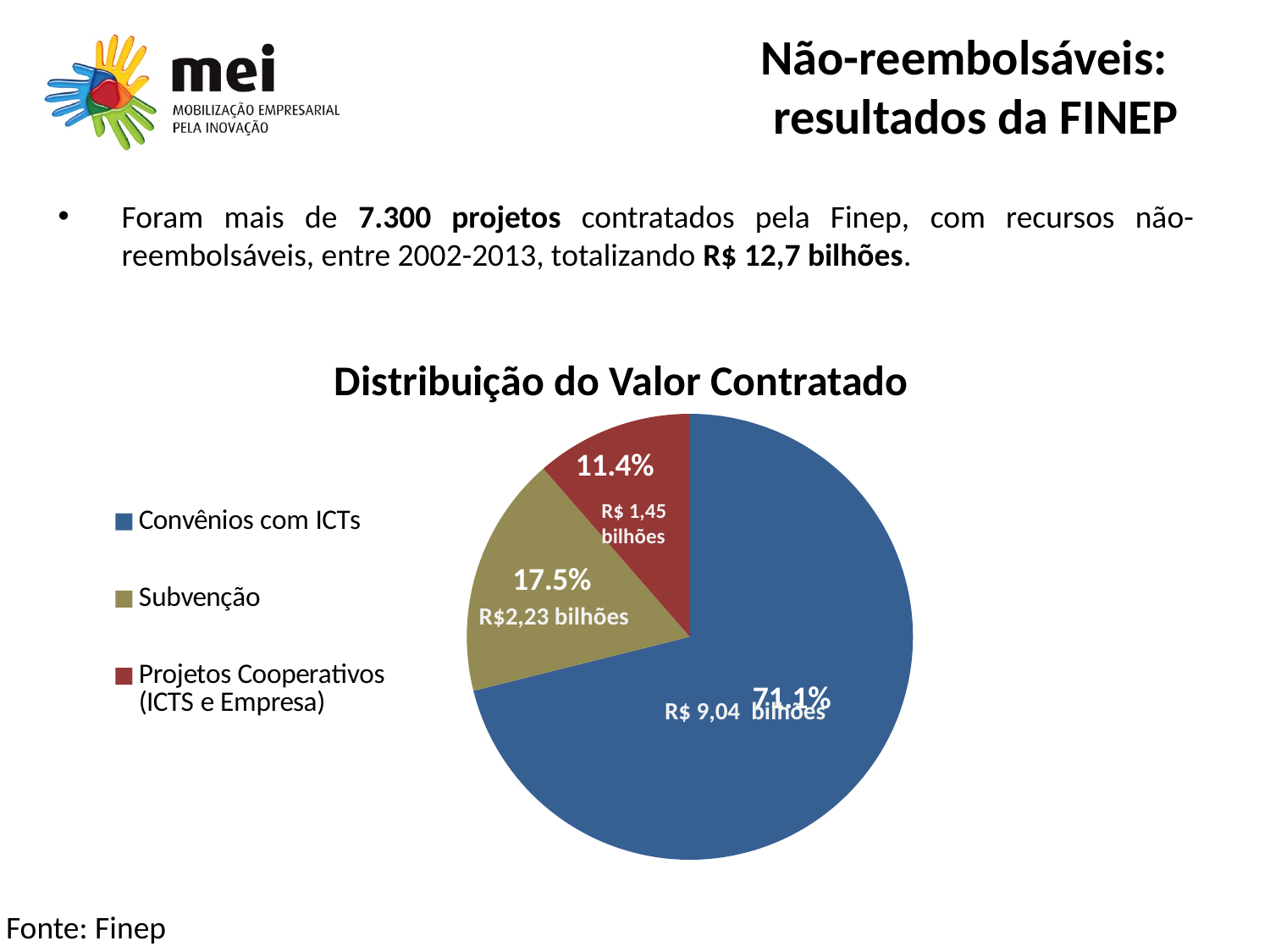
What value in bilhões is labelled on the Subvenção slice? R$2,23 bilhões What value in bilhões is labelled on the Projetos Cooperativos (ICTS e Empresa) slice? R$ 1,45 bilhões What kind of chart is shown under the title "Distribuição do Valor Contratado"? pie chart What share of the pie does Subvenção represent? 17.5% Which category has the largest slice of the pie? Convênios com ICTs Which category has the smallest slice of the pie? Projetos Cooperativos (ICTS e Empresa) Which is larger, the share for Subvenção or the share for Projetos Cooperativos (ICTS e Empresa)? Subvenção What is the difference in percentage points between the Subvenção share and the Projetos Cooperativos (ICTS e Empresa) share? 6.1 percentage points What share of the pie does Projetos Cooperativos (ICTS e Empresa) represent? 11.4% What share of the pie does Convênios com ICTs represent? 71.1% How many categories does the pie chart show? 3 What value in bilhões is labelled on the Convênios com ICTs slice? R$ 9,04 bilhões